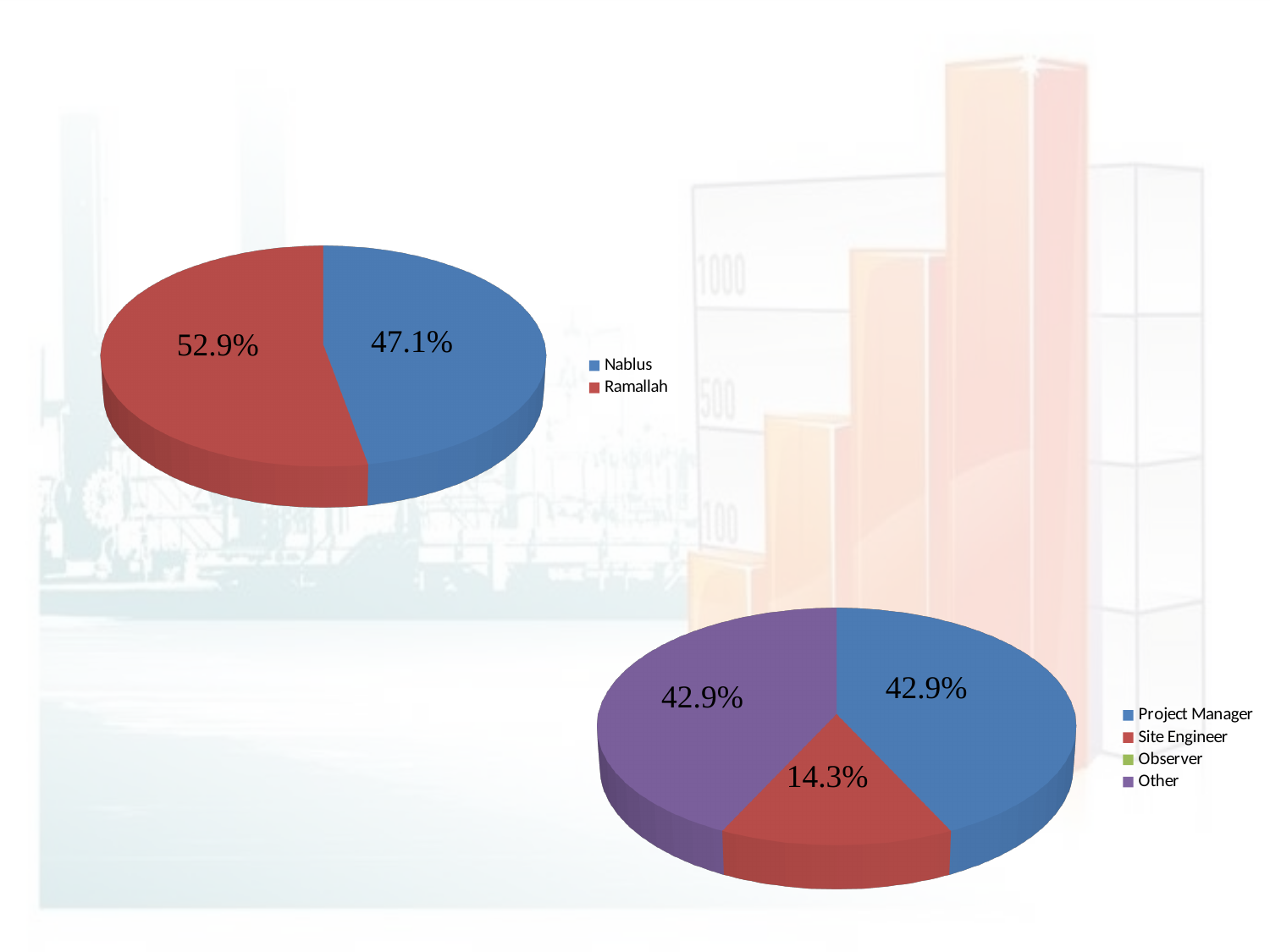
In the bottom-right pie chart, which is larger, the share for Project Manager or the share for Site Engineer? Project Manager In the bottom-right pie chart, how many categories does the legend list? 4 In the bottom-right pie chart, what colour is the Other slice? Purple In the top-left pie chart, how many categories does the legend list? 2 In the bottom-right pie chart, what percentage is shown for Other? 42.9% In the bottom-right pie chart, what percentage is shown for Project Manager? 42.9% In the top-left pie chart, what percentage is shown for Nablus? 47.1% What kind of chart is the top-left chart? Pie chart In the top-left pie chart, what is the difference in percentage points between Ramallah and Nablus? 5.8 In the bottom-right pie chart, what percentage is shown for Site Engineer? 14.3% In the top-left pie chart, what percentage is shown for Ramallah? 52.9% In the top-left pie chart, which category has the larger share? Ramallah